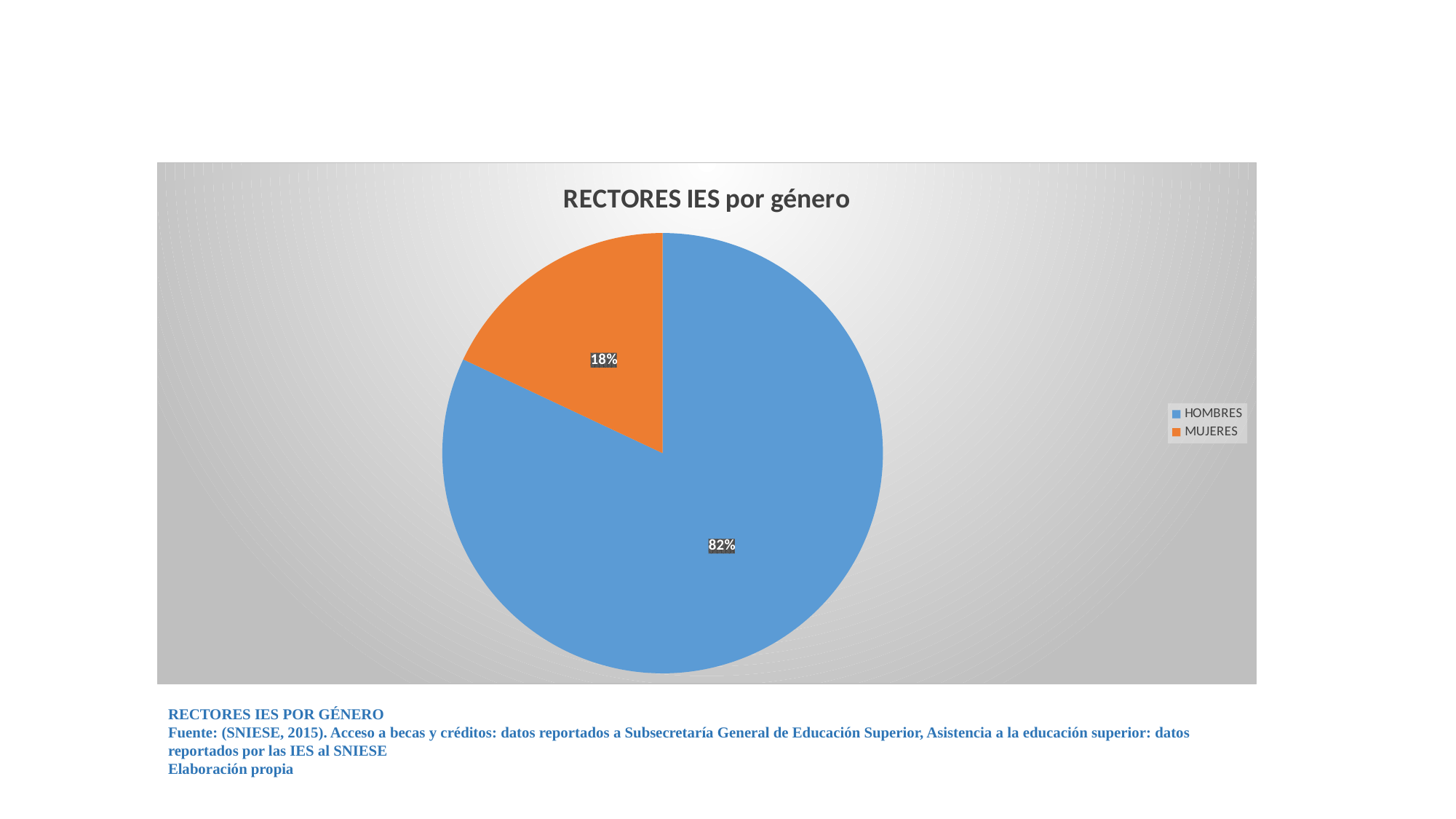
Which category has the smallest slice of the pie? MUJERES How many entries does the legend list? 2 How many categories does the pie chart show? 2 Which is larger, the HOMBRES slice or the MUJERES slice? HOMBRES What colour is the MUJERES slice? orange What kind of chart is shown on the slide? pie chart What share of the pie does HOMBRES represent? 82% What is the difference in percentage points between the HOMBRES and MUJERES slices? 64 Which category has the largest slice of the pie? HOMBRES What is the title of the chart? RECTORES IES por género What share of the pie does MUJERES represent? 18%